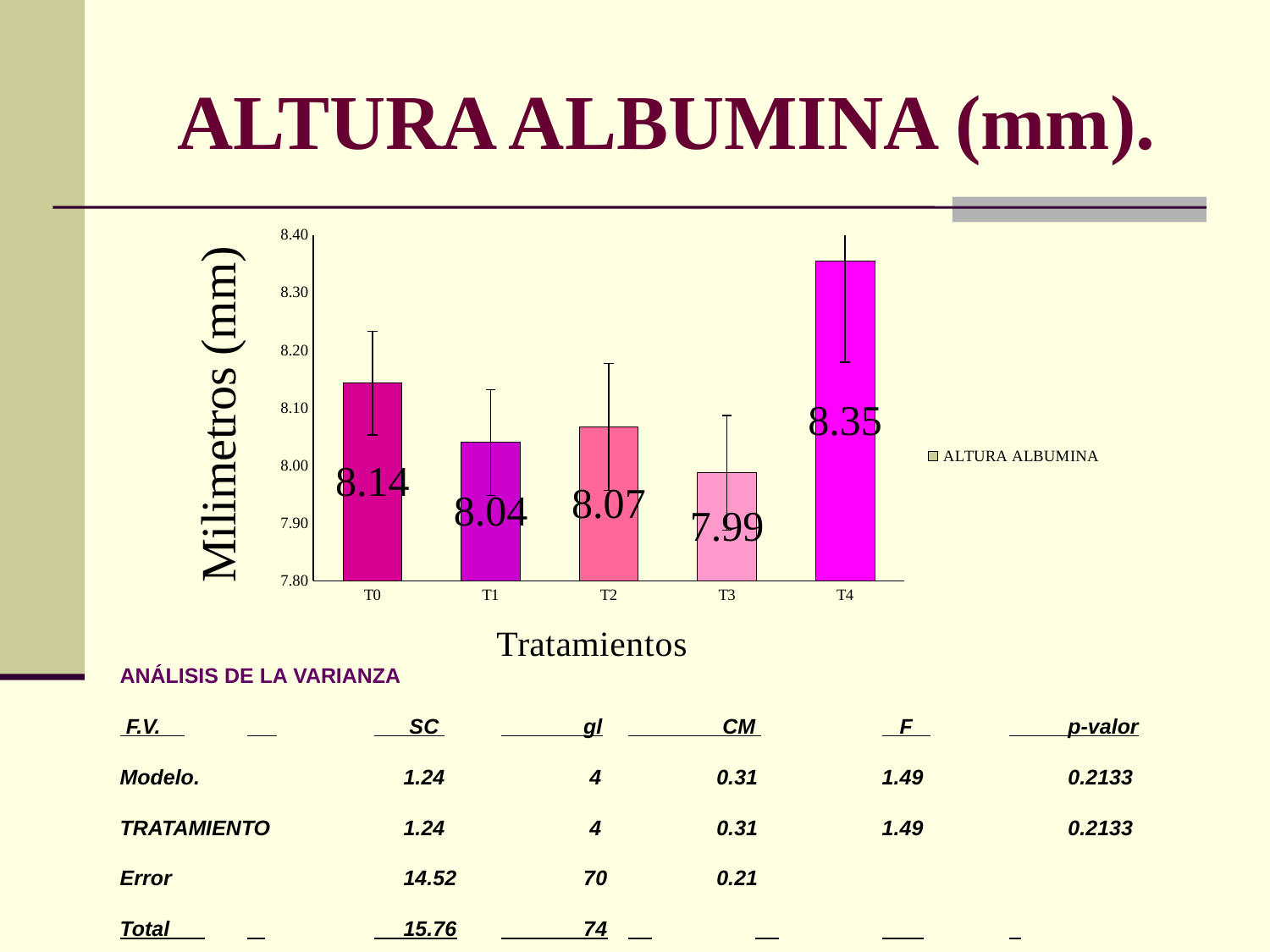
What is the value for T0? 8.14 Which treatment has the lowest value? T3 How many treatments are shown on the x axis? 5 What is the difference between the values for T4 and T3? 0.36 Is the value for T4 greater or less than 8.30? greater What is the label of the y axis? Milimetros (mm) What kind of chart is shown? bar chart What is the value for T3? 7.99 What is the difference between the values for T0 and T1? 0.10 Which treatment has the highest value? T4 Which is larger, the value for T1 or the value for T2? T2 What is the value for T4? 8.35